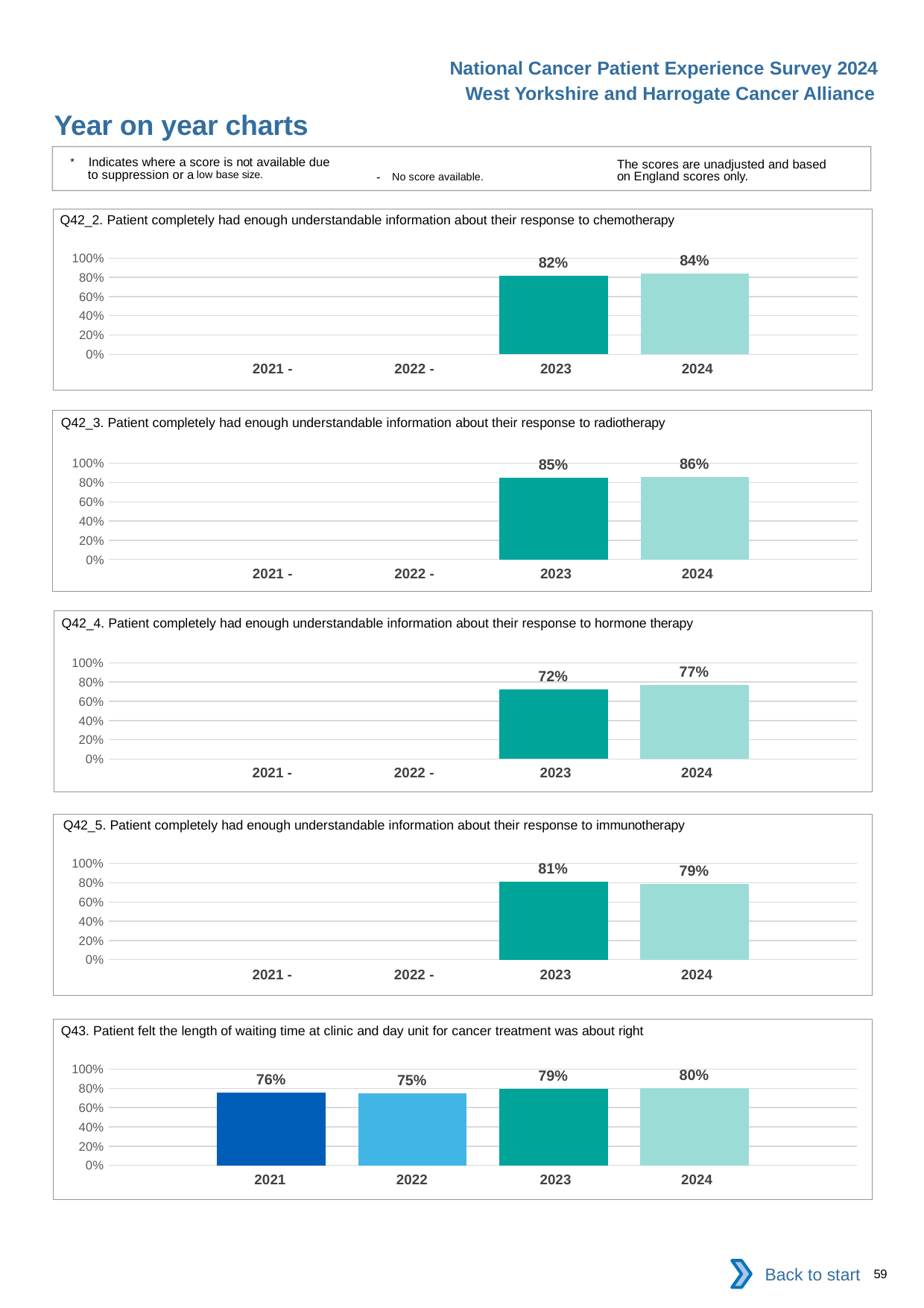
In the Q42_2 chart (chemotherapy), what is the difference between the 2024 and 2023 values? 2% In the Q42_3 chart (radiotherapy), what is the value for 2023? 85% In the Q42_2 chart (chemotherapy), what is the value for 2024? 84% In the Q42_4 chart (hormone therapy), which year has the higher value, 2023 or 2024? 2024 In the Q42_3 chart (radiotherapy), how many years have a score plotted? 2 In the Q43 chart (waiting time at clinic and day unit), what is the difference between the 2024 and 2021 values? 4% In the Q43 chart (waiting time at clinic and day unit), which year has the highest value? 2024 In the Q42_5 chart (immunotherapy), what is the value for 2024? 79% What kind of chart is the Q43 chart (waiting time at clinic and day unit)? bar chart In the Q43 chart (waiting time at clinic and day unit), which year has the lowest value? 2022 In the Q42_5 chart (immunotherapy), does the value rise or fall from 2023 to 2024? fall In the Q42_4 chart (hormone therapy), what is the difference between the 2024 and 2023 values? 5%